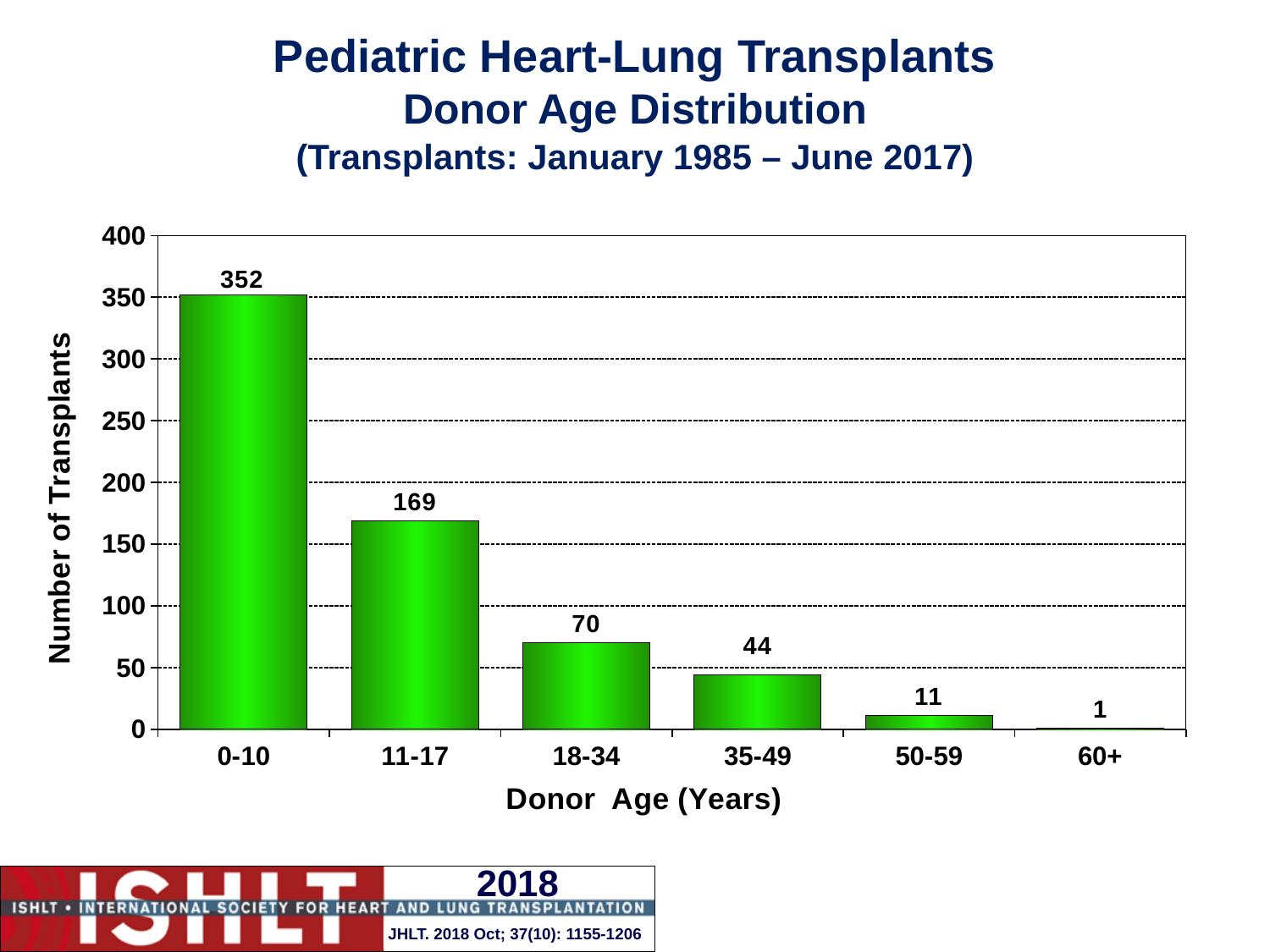
What kind of chart is shown on the slide? Bar chart What is the number of transplants for donors aged 11-17? 169 How many transplants are shown for the 0-10 donor age group? 352 What is the difference in transplants between the 0-10 and 11-17 donor age groups? 183 What is the difference between the 18-34 and 35-49 donor age groups? 26 Do the values rise or fall as donor age increases along the x axis? Fall Which has more transplants, the 18-34 group or the 50-59 group? 18-34 Is the value for the 11-17 donor age group greater or less than 150? greater How many donor age groups are shown on the x axis? 6 Which donor age group has the highest number of transplants? 0-10 What is the value for the 35-49 donor age group? 44 Which donor age group has the lowest number of transplants? 60+